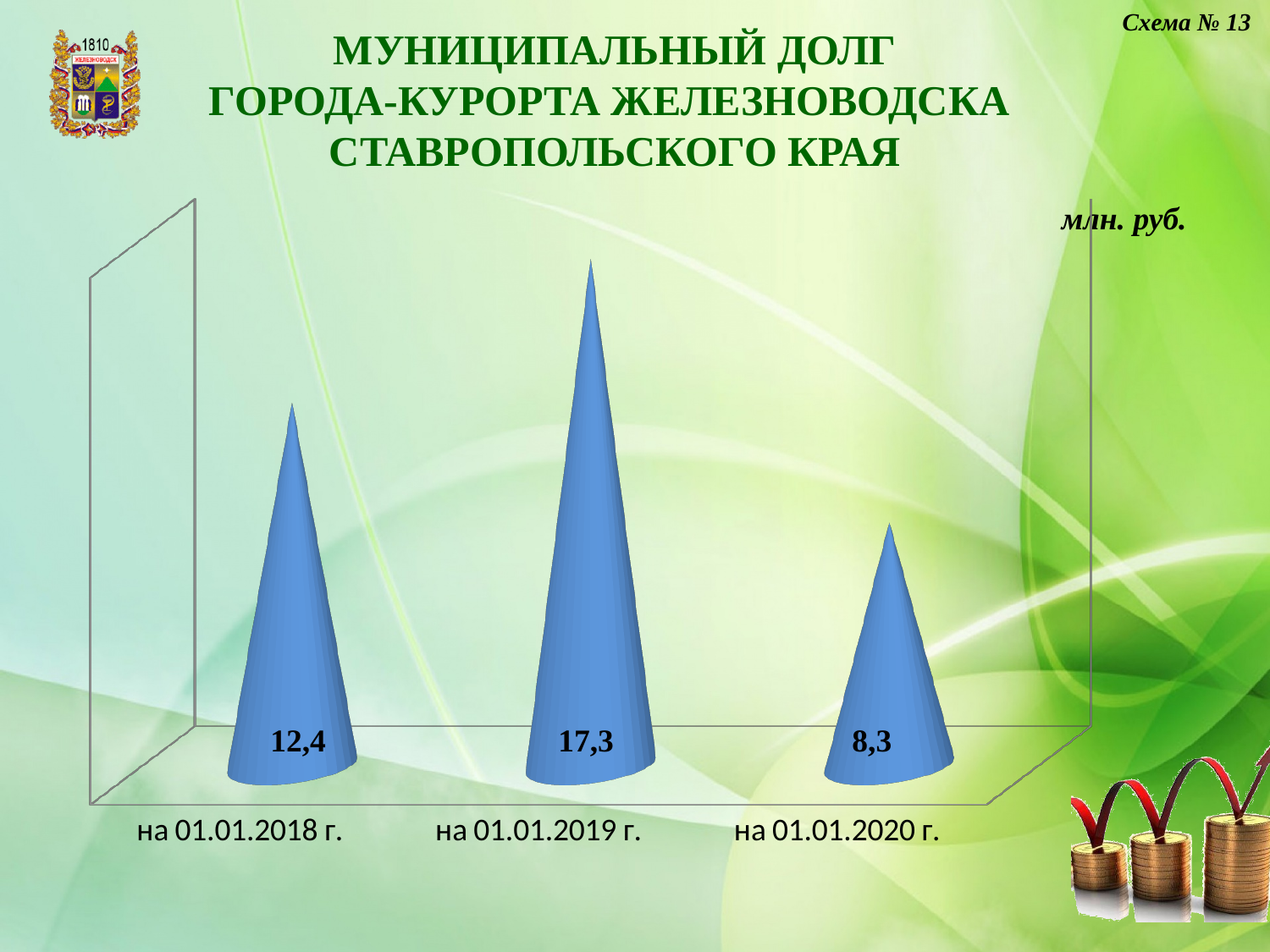
Which date has the highest municipal debt value? на 01.01.2019 г. What is the municipal debt value shown for на 01.01.2019 г.? 17,3 Which date has the lowest municipal debt value? на 01.01.2020 г. What is the difference between the values for на 01.01.2019 г. and на 01.01.2020 г.? 9,0 What is the municipal debt value shown for на 01.01.2018 г.? 12,4 What kind of chart is shown on the slide? bar chart What is the municipal debt value shown for на 01.01.2020 г.? 8,3 Which is larger, the value for на 01.01.2018 г. or the value for на 01.01.2020 г.? на 01.01.2018 г. What is the difference between the values for на 01.01.2019 г. and на 01.01.2018 г.? 4,9 Does the municipal debt rise or fall from на 01.01.2019 г. to на 01.01.2020 г.? fall In what units are the values on the chart expressed? млн. руб. How many dates (categories) are shown on the chart? 3